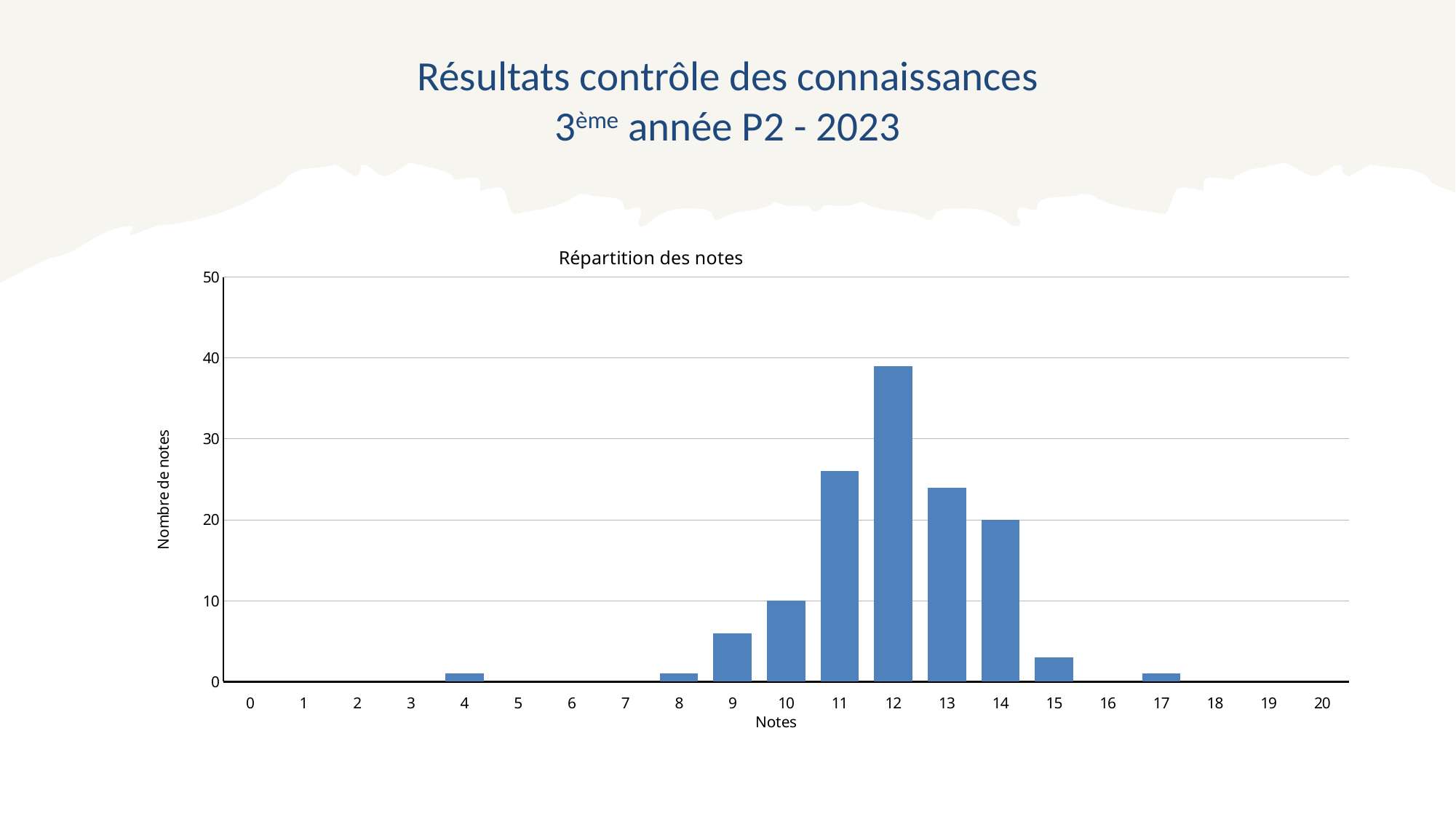
Which note has the highest number of notes? 12 Which is larger, the value for note 11 or the value for note 13? 11 Is the value for note 9 greater or less than 10? less How many note categories are shown on the x axis? 21 Is the value for note 13 greater or less than 20? greater Is the value for note 12 greater or less than 30? greater What is the number of notes for note 10? 10 What is the number of notes for note 14? 20 What is the label of the y axis? Nombre de notes What kind of chart is shown on the slide? bar chart What is the title of the chart? Répartition des notes